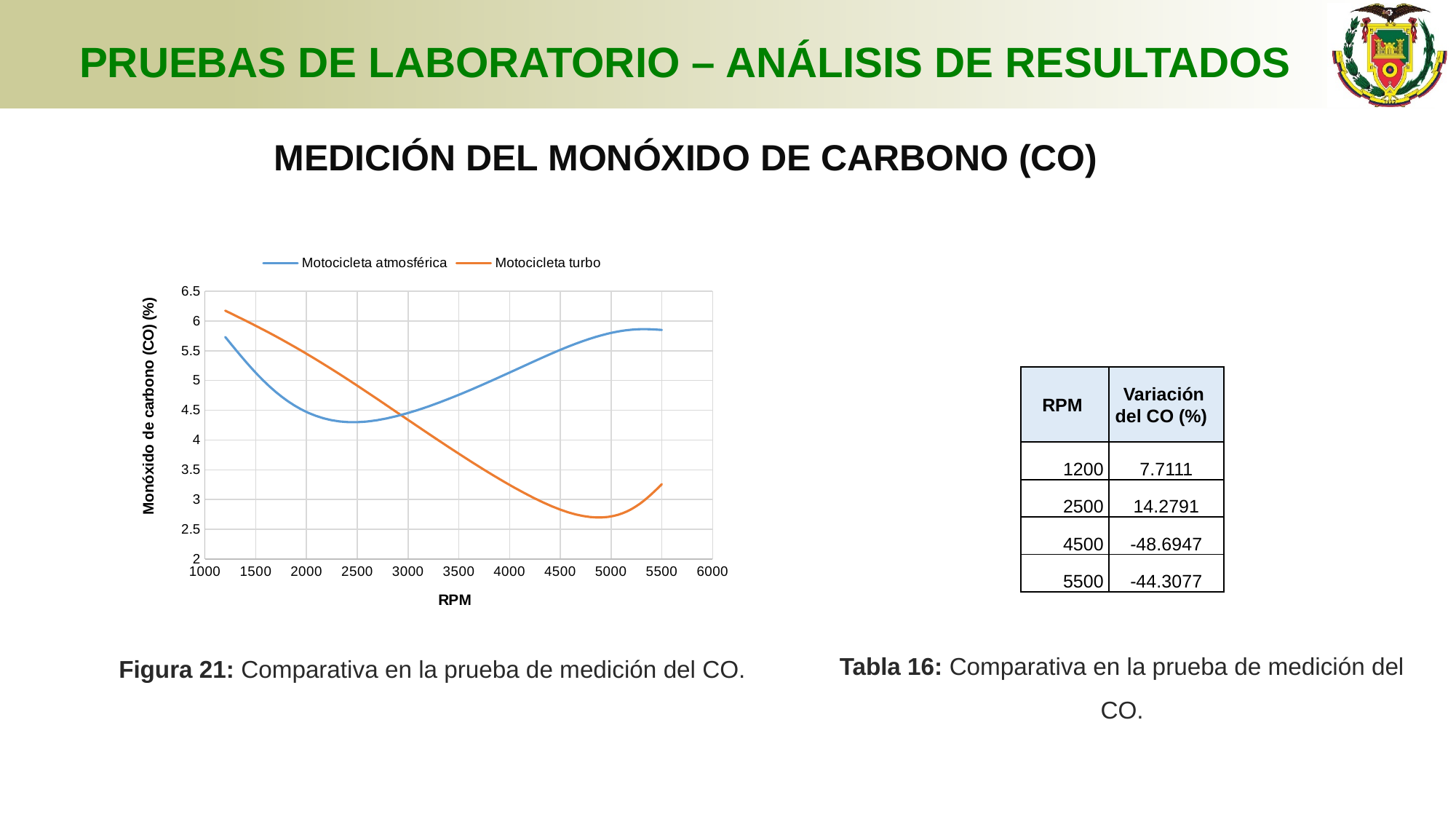
Is the value for Motocicleta turbo at 1200 RPM greater or less than 6? greater What is the label of the vertical axis of the chart? Monóxido de carbono (CO) (%) At 1500 RPM, which series has the higher CO value, Motocicleta atmosférica or Motocicleta turbo? Motocicleta turbo What kind of chart is shown in Figura 21? line chart Is the value for Motocicleta atmosférica at 5000 RPM greater or less than 5.5? greater What are the two series named in the chart legend? Motocicleta atmosférica and Motocicleta turbo Does the Motocicleta turbo line rise or fall between 1200 RPM and 4500 RPM? fall How many series does the legend of the chart list? 2 At 5000 RPM, which series has the higher CO value, Motocicleta atmosférica or Motocicleta turbo? Motocicleta atmosférica Is the value for Motocicleta atmosférica at 2500 RPM greater or less than 4.5? less